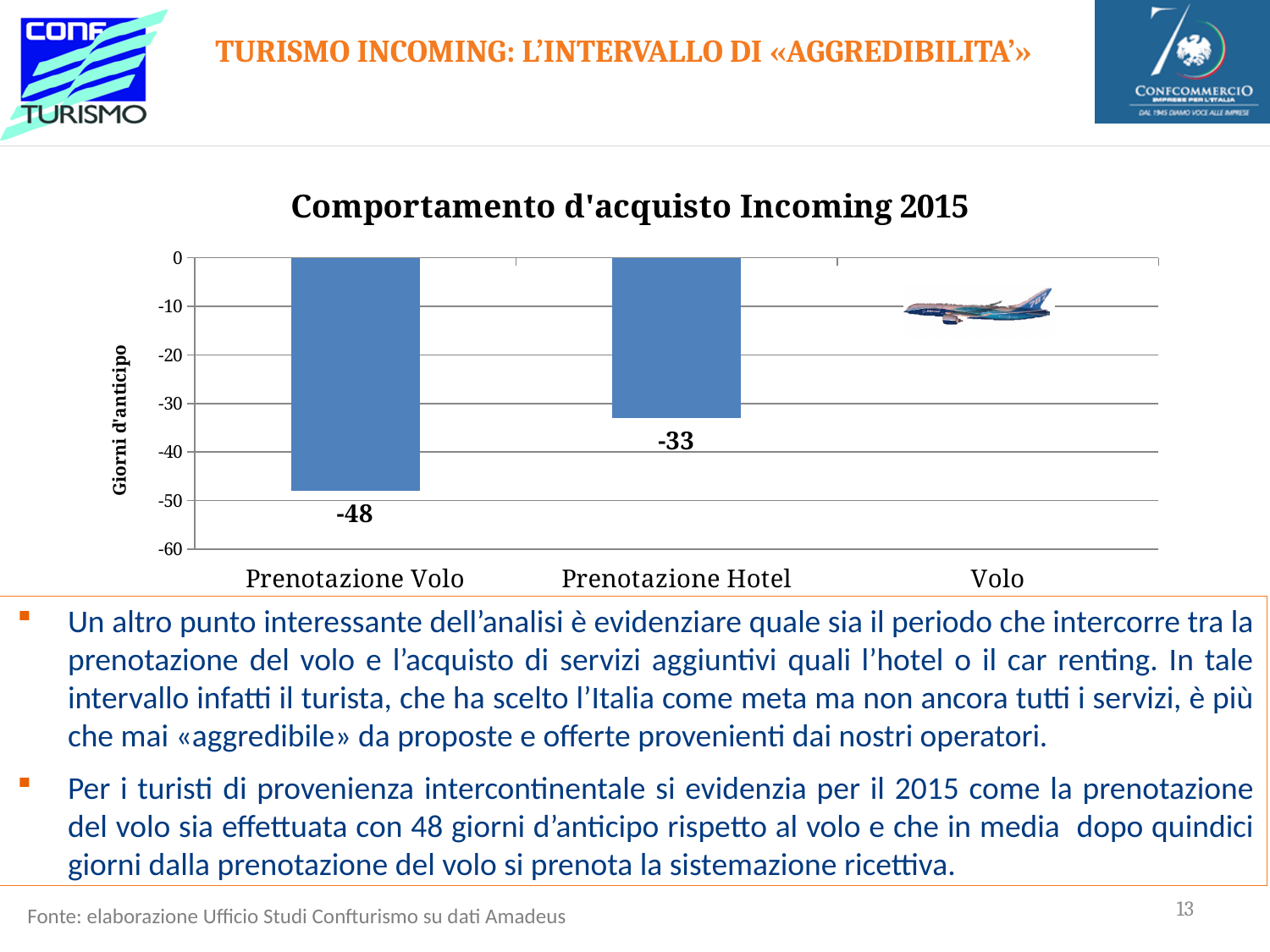
What is the difference between the values for Prenotazione Volo and Prenotazione Hotel? 15 What is the title of the chart? Comportamento d'acquisto Incoming 2015 What is the value for Prenotazione Volo in the chart? -48 Which of the two plotted bars, Prenotazione Volo or Prenotazione Hotel, has the higher value? Prenotazione Hotel Is the value for Prenotazione Hotel greater or less than -40? greater What kind of chart is shown on the slide? bar chart Is the value for Prenotazione Volo greater or less than -40? less What is the label of the vertical axis of the chart? Giorni d'anticipo Does the value rise or fall from Prenotazione Volo to Prenotazione Hotel? rise Which category has the lowest value in the chart? Prenotazione Volo How many categories are labelled on the x axis of the chart? 3 What is the value for Prenotazione Hotel in the chart? -33